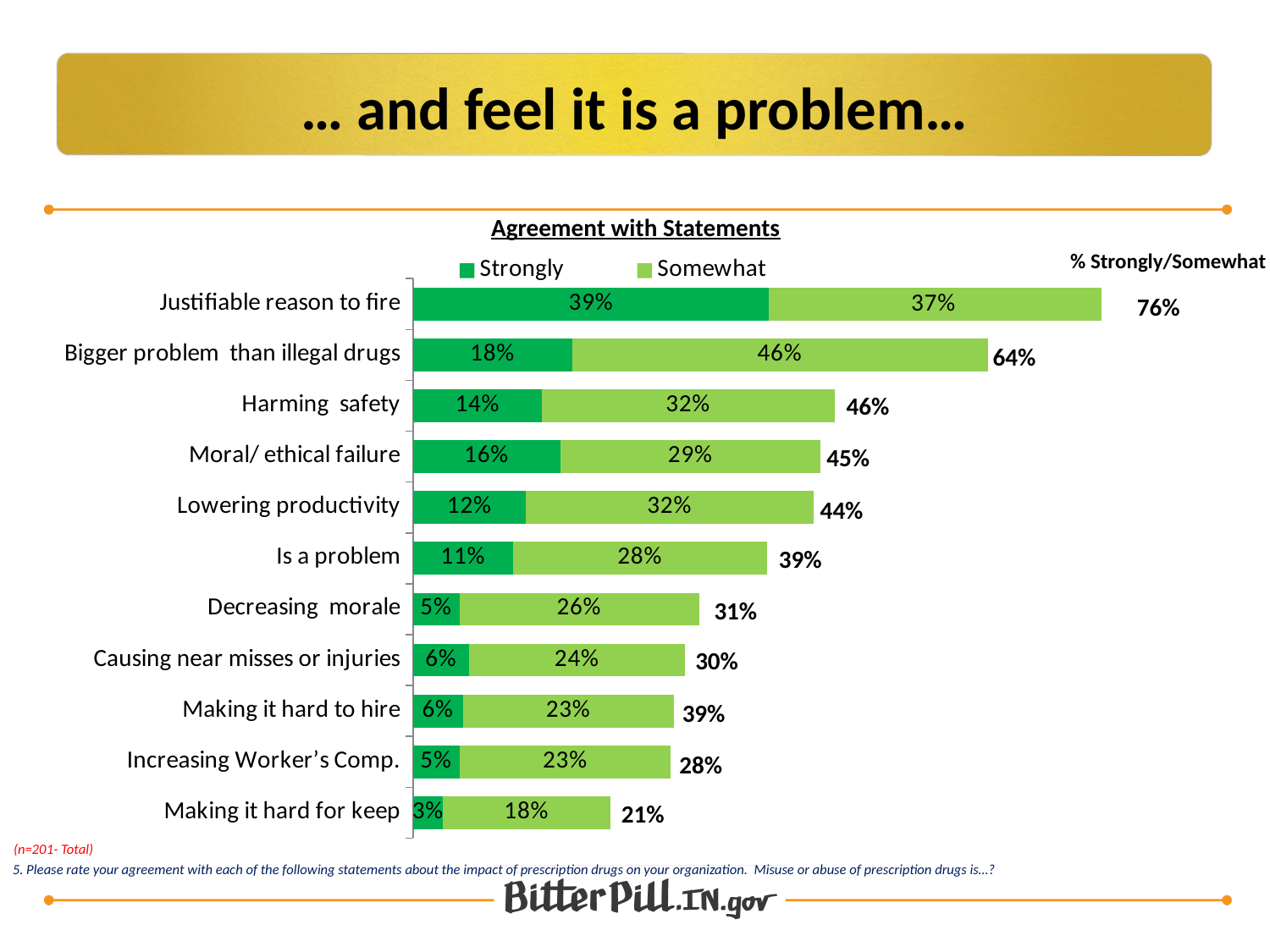
How many statements (categories) are plotted in the Agreement with Statements chart? 11 Which statement has the highest Strongly value? Justifiable reason to fire What is the difference between the Somewhat values for 'Bigger problem than illegal drugs' and 'Harming safety'? 14% What is the Somewhat value for 'Making it hard for keep'? 18% What is the Somewhat value for 'Bigger problem than illegal drugs'? 46% What is the combined Strongly/Somewhat total for 'Lowering productivity'? 44% What is the Strongly value for 'Justifiable reason to fire'? 39% Which statement has the lowest Strongly value? Making it hard for keep Which is larger: the Strongly value for 'Moral/ ethical failure' or the Strongly value for 'Harming safety'? Moral/ ethical failure What type of chart is shown on the slide? Stacked bar chart What is the title of the chart on the slide? Agreement with Statements How many series does the legend list in the Agreement with Statements chart? 2